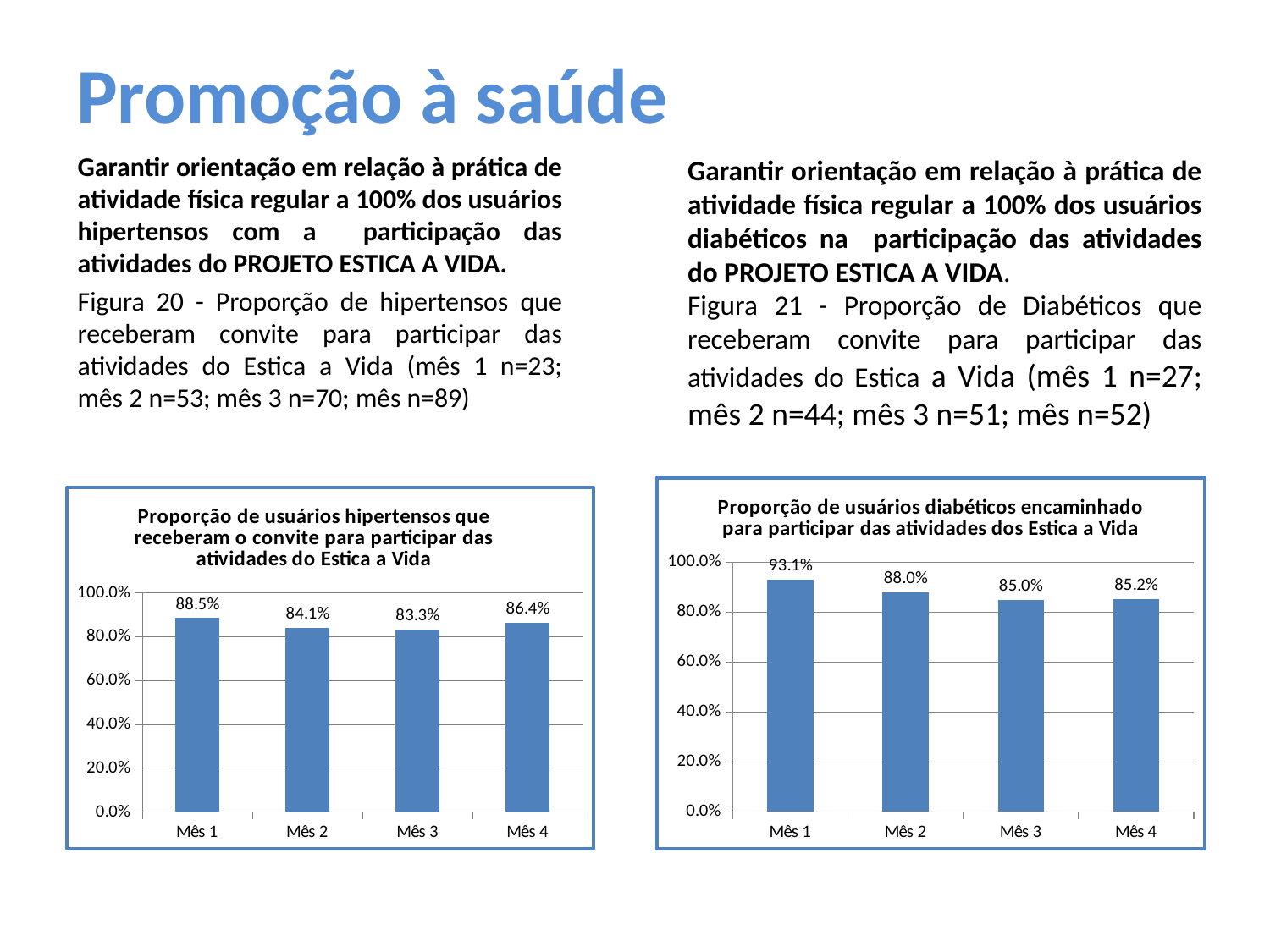
Which is larger: Mês 2 in the left chart (hipertensos) or Mês 2 in the right chart (diabéticos)? Mês 2 in the right chart (diabéticos) In the right chart (diabéticos), what is the value for Mês 4? 85.2% In the left chart (hipertensos), what is the difference between Mês 1 and Mês 3? 5.2% In the right chart (diabéticos), what is the value for Mês 1? 93.1% In the left chart (hipertensos), what is the value for Mês 1? 88.5% In the left chart (hipertensos), how many months are plotted? 4 What kind of chart is the right chart (diabéticos)? Bar chart In the left chart (hipertensos), which month has the highest value? Mês 1 In the right chart (diabéticos), which month has the lowest value? Mês 3 In the left chart (hipertensos), what is the value for Mês 3? 83.3% In the right chart (diabéticos), what is the difference between Mês 1 and Mês 2? 5.1% In the right chart (diabéticos), is the value for Mês 2 greater or less than 80.0%? greater